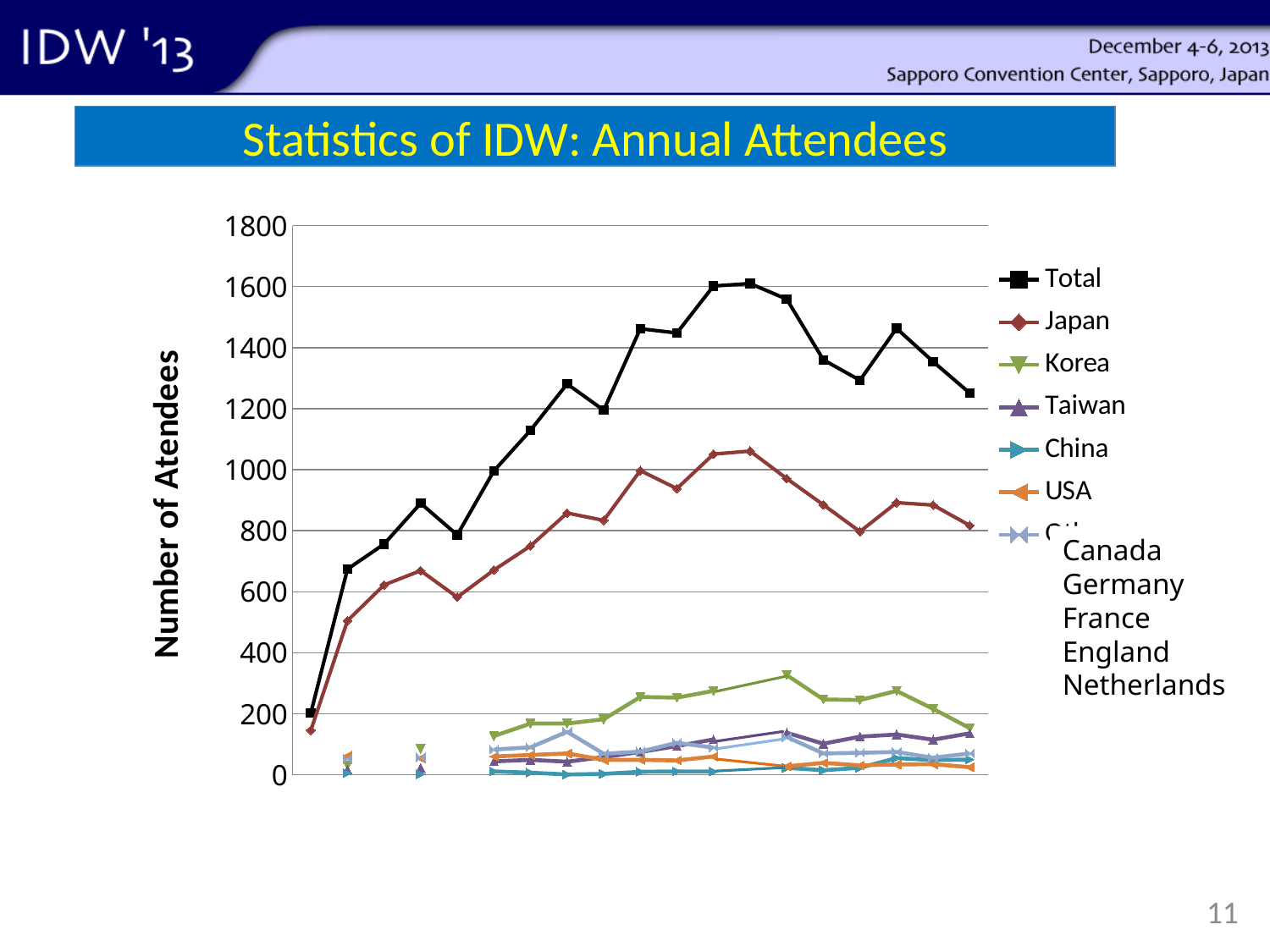
What is the label of the vertical axis? Number of Atendees What kind of chart is shown on the slide? line chart Is the highest value of the Korea series greater or less than 400? less Is the last plotted value of the Total series greater or less than 1200? greater Which series reaches the highest value on the chart? Total Is the first plotted value of the Total series greater or less than 400? less Which series has the larger peak value, Korea or Taiwan? Korea Does the Total series rise or fall from its first point to its highest point? rise Which series stays lowest across the chart, China or Korea? China Which series is higher at every point, Total or Japan? Total What is the title of the slide's chart? Statistics of IDW: Annual Attendees